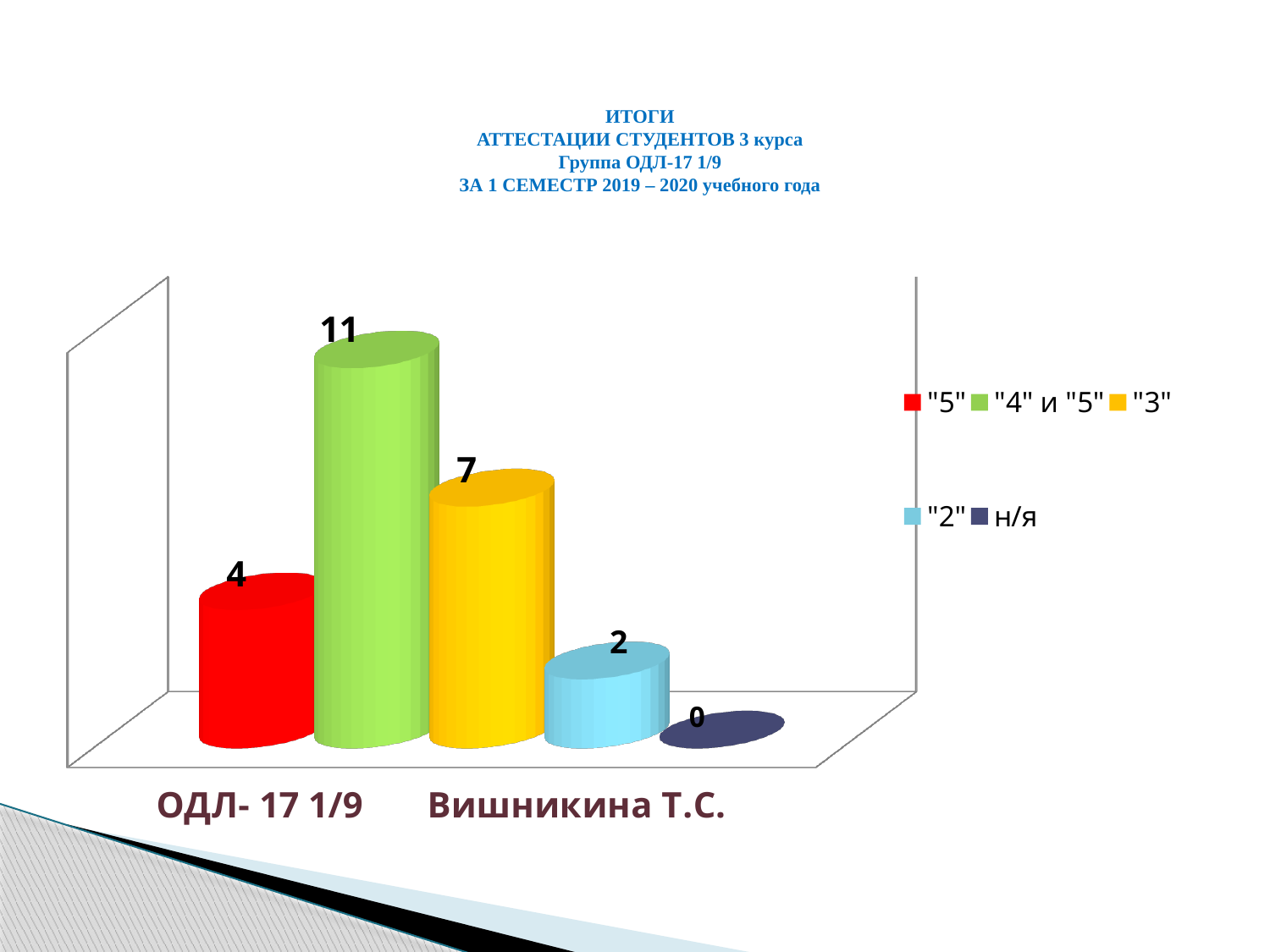
What kind of chart is shown on the slide? bar chart Which is larger, the value for "5" or the value for "2"? "5" What is the value for "4" и "5"? 11 How many series does the legend list? 5 What is the value for "3"? 7 Which series has the lowest value? н/я Which series has the highest value? "4" и "5" What colour is the bar for "3"? yellow What is the difference between the values for "4" и "5" and "3"? 4 What is the value for "5"? 4 What is the value for н/я? 0 What is the value for "2"? 2